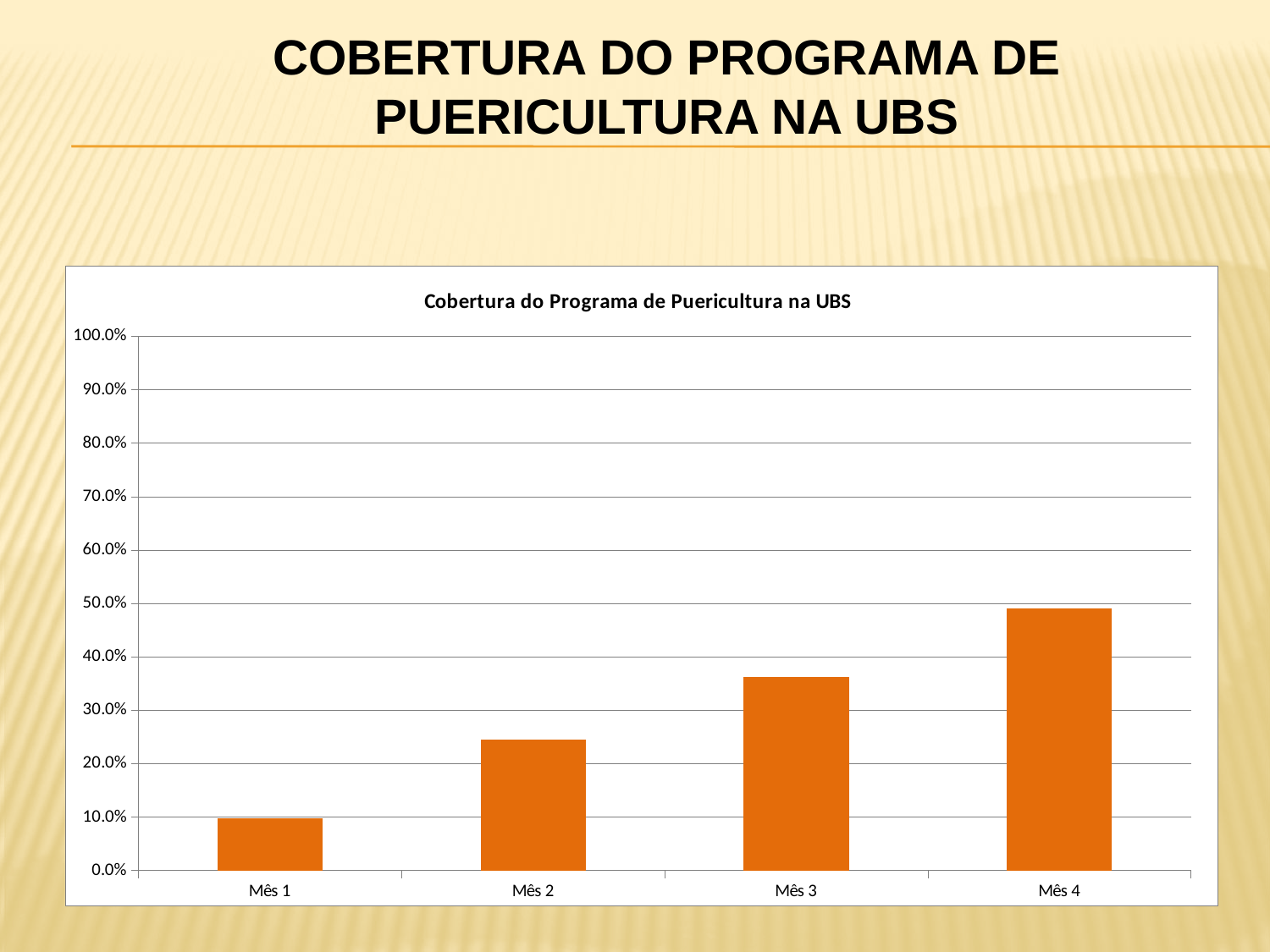
Do the values rise or fall from Mês 1 to Mês 4? rise Is the value for Mês 1 greater or less than 20.0%? less What kind of chart is shown on the slide? bar chart Is the value for Mês 3 greater or less than 30.0%? greater Is the value for Mês 2 greater or less than 20.0%? greater Which month has the lowest coverage? Mês 1 How many months (categories) are plotted on the chart? 4 What is the title of the chart? Cobertura do Programa de Puericultura na UBS Which is larger, the value for Mês 3 or the value for Mês 2? Mês 3 Which month has the highest coverage? Mês 4